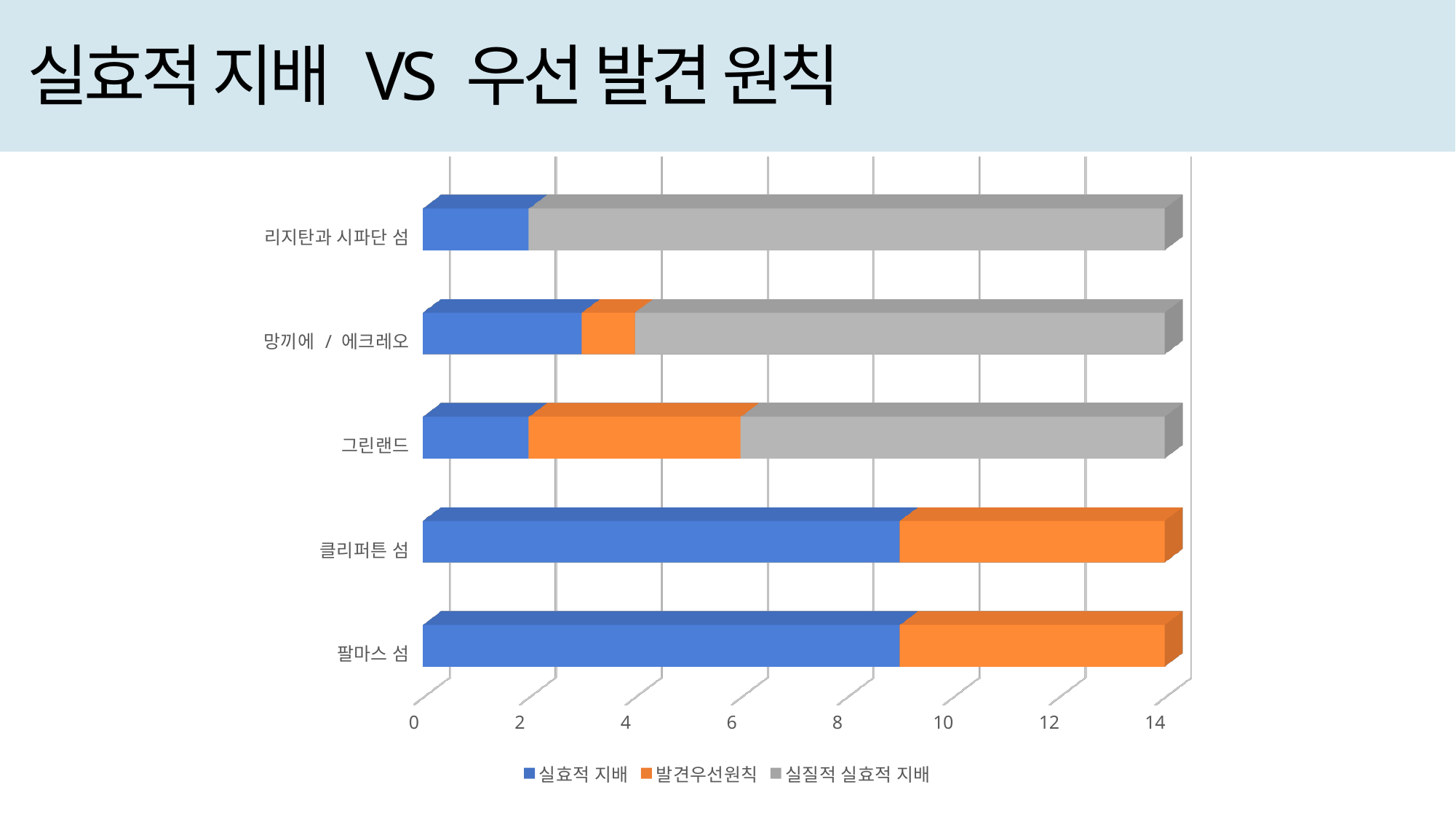
Which category has no 발견우선원칙 segment? 리지탄과 시파단 섬 Which category has the largest 실질적 실효적 지배 segment? 리지탄과 시파단 섬 Is the 실효적 지배 value for 리지탄과 시파단 섬 greater or less than 4? less Is the 실효적 지배 value for 클리퍼튼 섬 greater or less than 8? greater How many categories are plotted on the chart? 5 What kind of chart is shown on the slide? bar chart What colour represents 발견우선원칙 in the legend? orange Which has the larger 실효적 지배 segment, 클리퍼튼 섬 or 그린랜드? 클리퍼튼 섬 How many series does the legend list? 3 Is the 실효적 지배 value for 팔마스 섬 greater or less than 6? greater Which category has the smallest 실질적 실효적 지배 segment among those that have one? 그린랜드 Which has the larger 발견우선원칙 segment, 그린랜드 or 망끼에 / 에크레오? 그린랜드